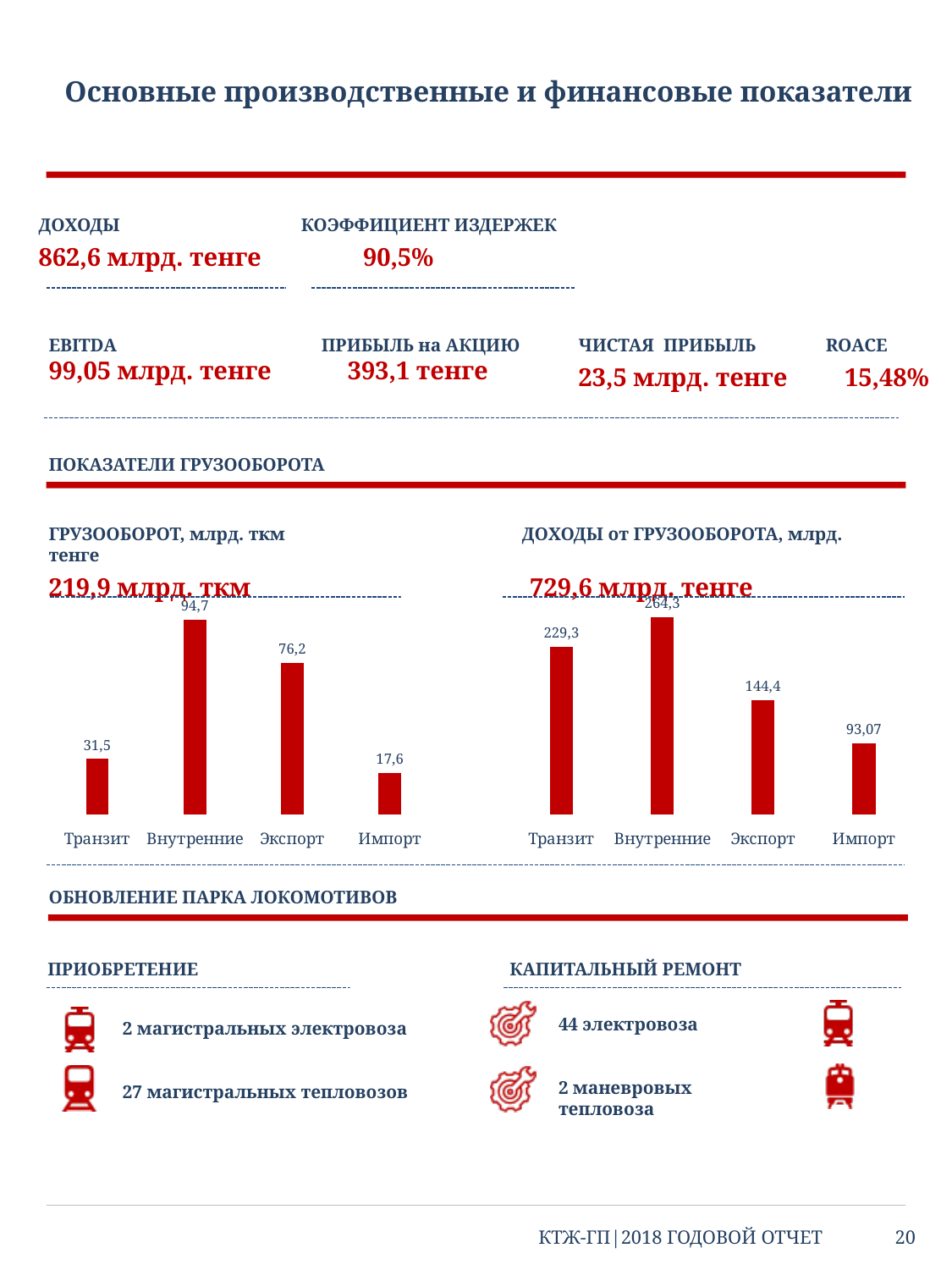
In the right chart (ДОХОДЫ от ГРУЗООБОРОТА), what is the value for Импорт? 93,07 How many categories are shown in the left chart (ГРУЗООБОРОТ, млрд. ткм)? 4 In the right chart (ДОХОДЫ от ГРУЗООБОРОТА), what is the value for Транзит? 229,3 In the left chart (ГРУЗООБОРОТ, млрд. ткм), what is the value for Внутренние? 94,7 In the right chart (ДОХОДЫ от ГРУЗООБОРОТА), what is the difference between Внутренние and Транзит? 35 In the left chart (ГРУЗООБОРОТ, млрд. ткм), which category has the highest value? Внутренние In the left chart (ГРУЗООБОРОТ, млрд. ткм), what is the difference between Внутренние and Экспорт? 18,5 In the left chart (ГРУЗООБОРОТ, млрд. ткм), what is the value for Импорт? 17,6 What total is printed above the left chart (ГРУЗООБОРОТ)? 219,9 млрд. ткм What kind of chart is the right chart (ДОХОДЫ от ГРУЗООБОРОТА)? Bar chart In the right chart (ДОХОДЫ от ГРУЗООБОРОТА), which is larger, Экспорт or Импорт? Экспорт In the right chart (ДОХОДЫ от ГРУЗООБОРОТА), which category has the lowest value? Импорт